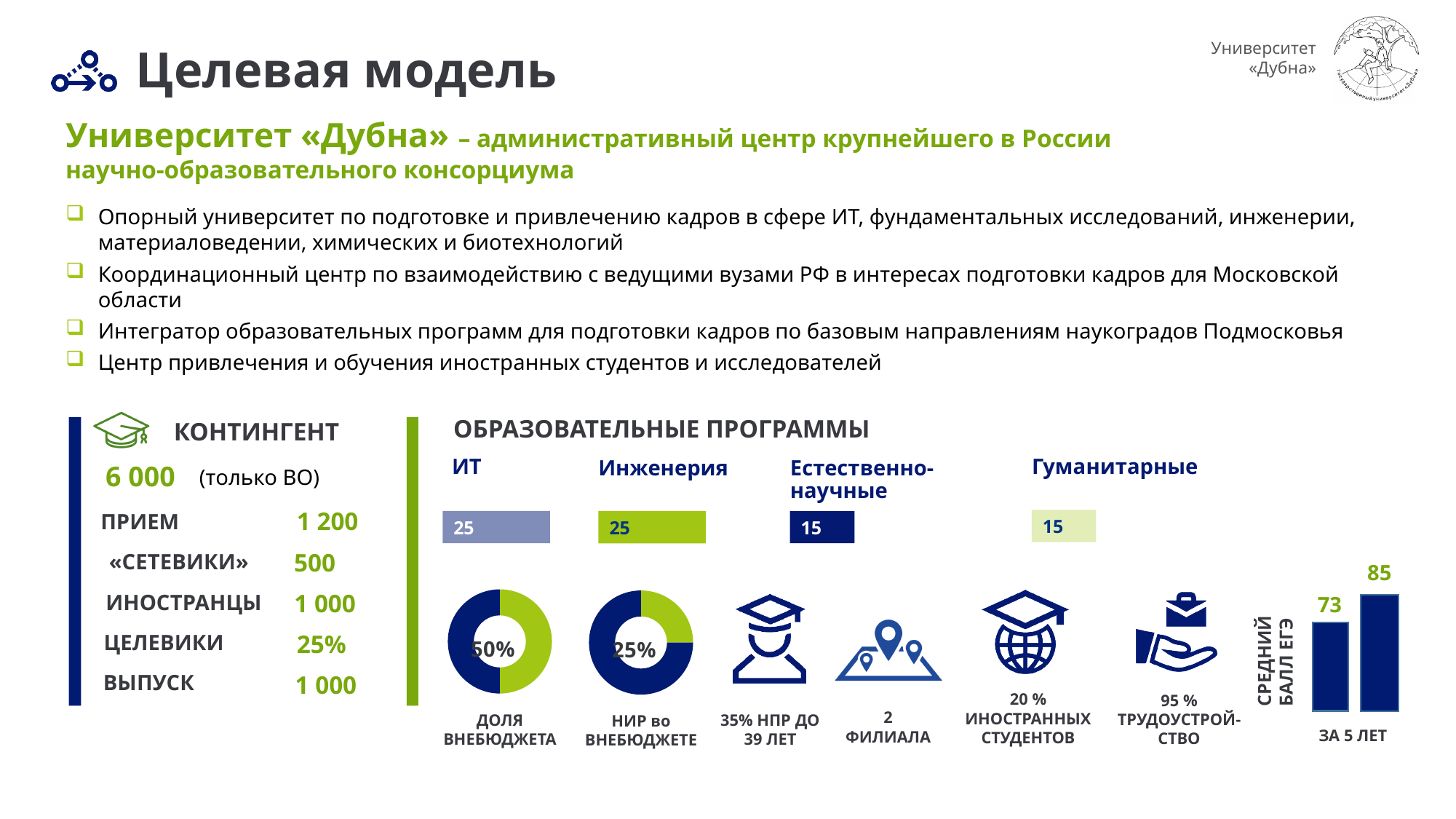
In the 'Образовательные программы' chart, how many categories are shown? 4 In the 'Средний балл ЕГЭ' chart, do the values rise or fall from left to right? rise In the 'Средний балл ЕГЭ' chart, what is the difference between the two bars? 12 In the 'НИР во внебюджете' donut chart, what share is shown? 25% In the 'Образовательные программы' chart, what is the value for Естественно-научные? 15 In the 'Образовательные программы' chart, what is the value for Гуманитарные? 15 In the 'Средний балл ЕГЭ' chart, what is the value of the second (right) bar? 85 In the 'Образовательные программы' chart, which is larger: Инженерия or Гуманитарные? Инженерия In the 'Образовательные программы' chart, what is the difference between ИТ and Естественно-научные? 10 In the 'Образовательные программы' chart, what is the value for ИТ? 25 In the 'Доля внебюджета' donut chart, what share is shown? 50% In the 'Средний балл ЕГЭ' chart, what is the value of the first (left) bar? 73